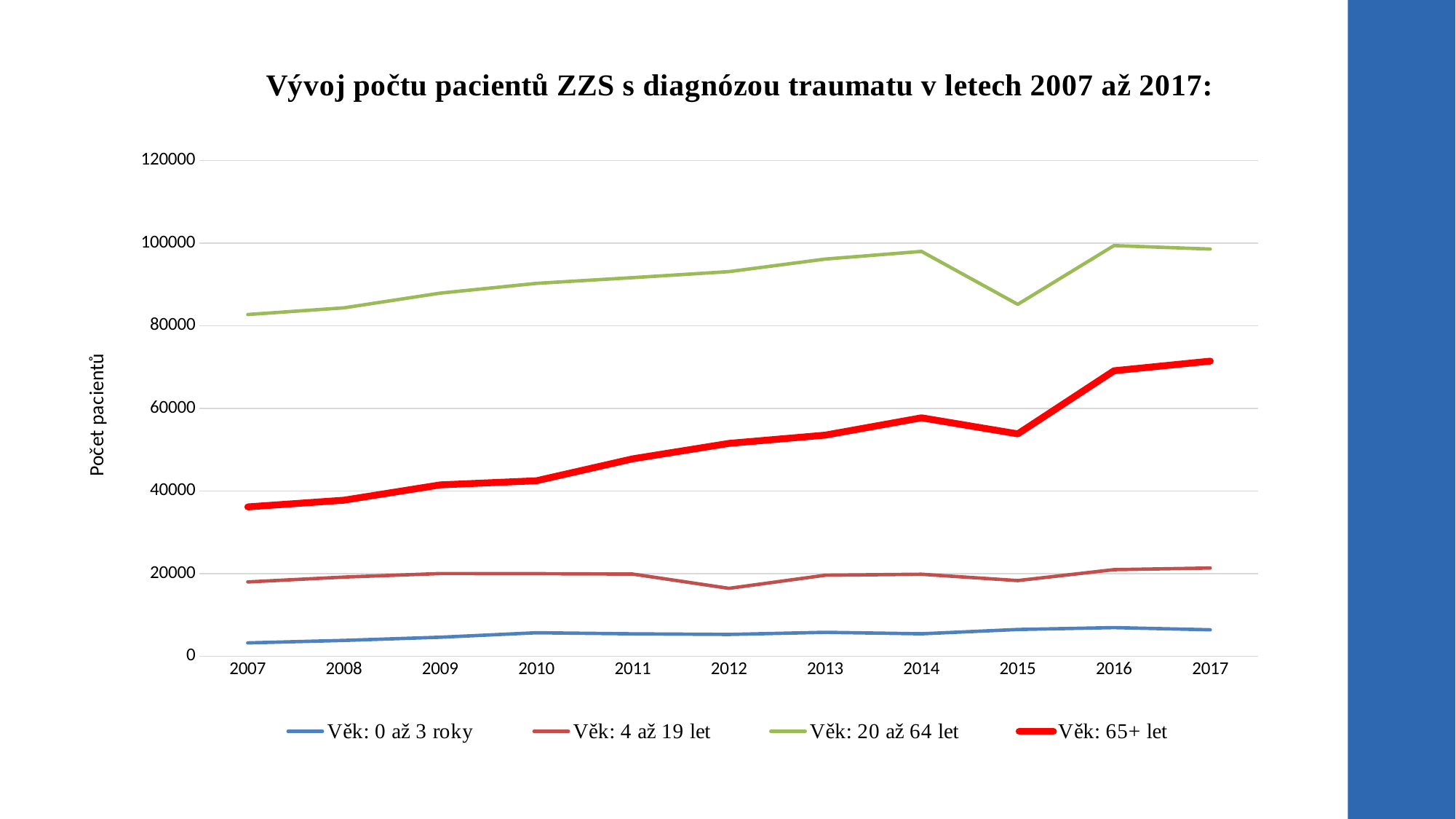
Which series has the lowest values across all years? Věk: 0 až 3 roky Is the value for Věk: 65+ let in 2007 greater or less than 40000? less Is the value for Věk: 65+ let in 2017 greater or less than 60000? greater What is the title of the chart? Vývoj počtu pacientů ZZS s diagnózou traumatu v letech 2007 až 2017: Is the value for Věk: 4 až 19 let in 2012 greater or less than 20000? less What kind of chart is shown on the slide? line chart Does the value for Věk: 65+ let rise or fall from 2007 to 2017? rise What is the label of the vertical axis? Počet pacientů How many series does the legend list? 4 How many years are plotted along the x axis? 11 Which series has the highest value in 2017? Věk: 20 až 64 let